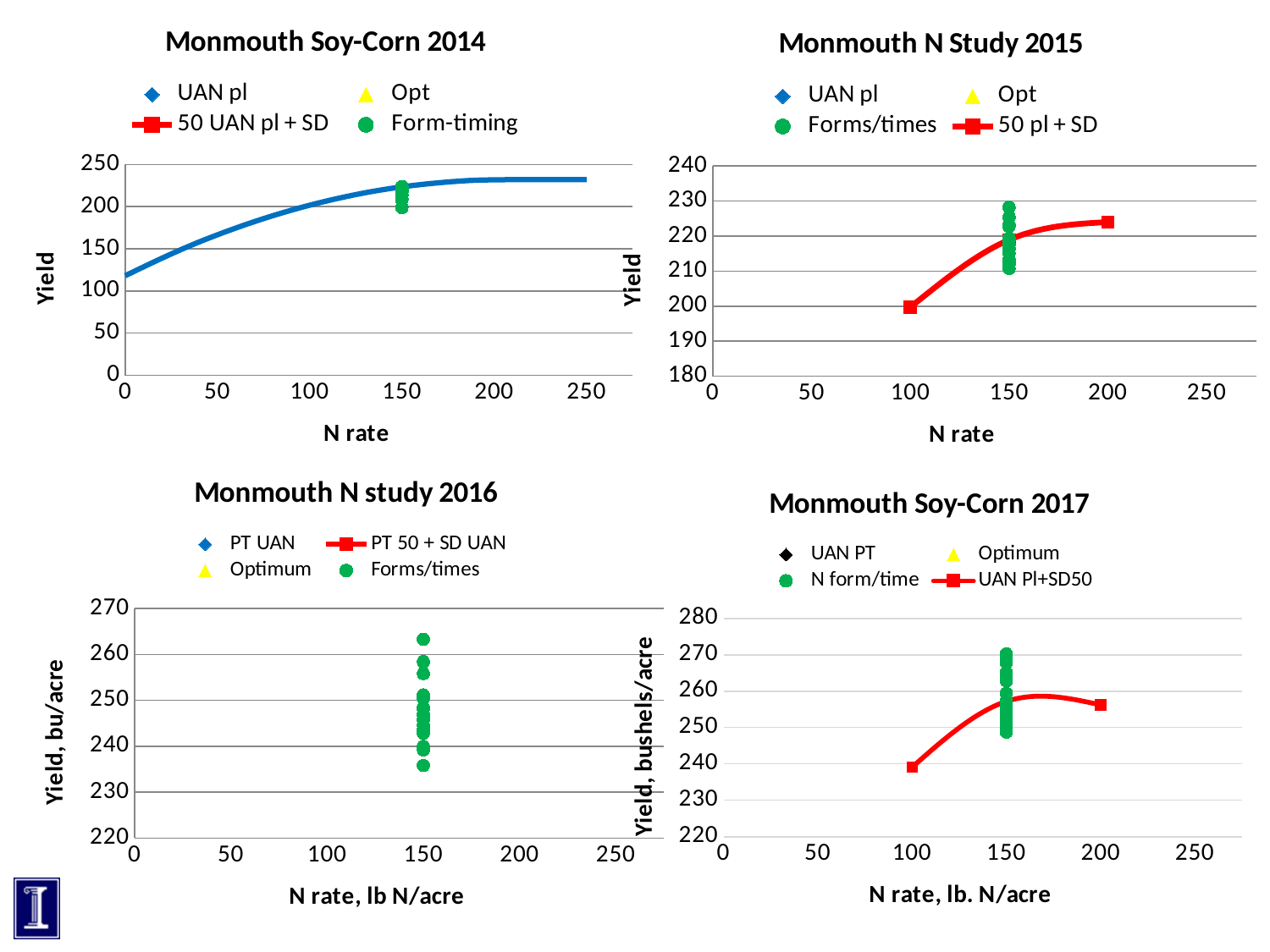
In the Monmouth N study 2016 chart, is the lowest Forms/times point greater or less than 240? less In the Monmouth N Study 2015 chart, is the value of the 50 pl + SD series at N rate 100 greater or less than 210? less In the Monmouth N Study 2015 chart, does the 50 pl + SD line rise or fall as N rate increases from 100 to 200? rise What is the y-axis title of the Monmouth N study 2016 chart? Yield, bu/acre In the Monmouth Soy-Corn 2017 chart, is the value of the UAN Pl+SD50 series at N rate 100 greater or less than 250? less In the Monmouth Soy-Corn 2017 chart, which is larger for the UAN Pl+SD50 series: the value at N rate 100 or at N rate 150? N rate 150 What is the x-axis title of the Monmouth Soy-Corn 2017 chart? N rate, lb. N/acre In the Monmouth Soy-Corn 2014 chart, how many series does the legend list? 4 What kind of chart is the Monmouth Soy-Corn 2014 chart? scatter chart